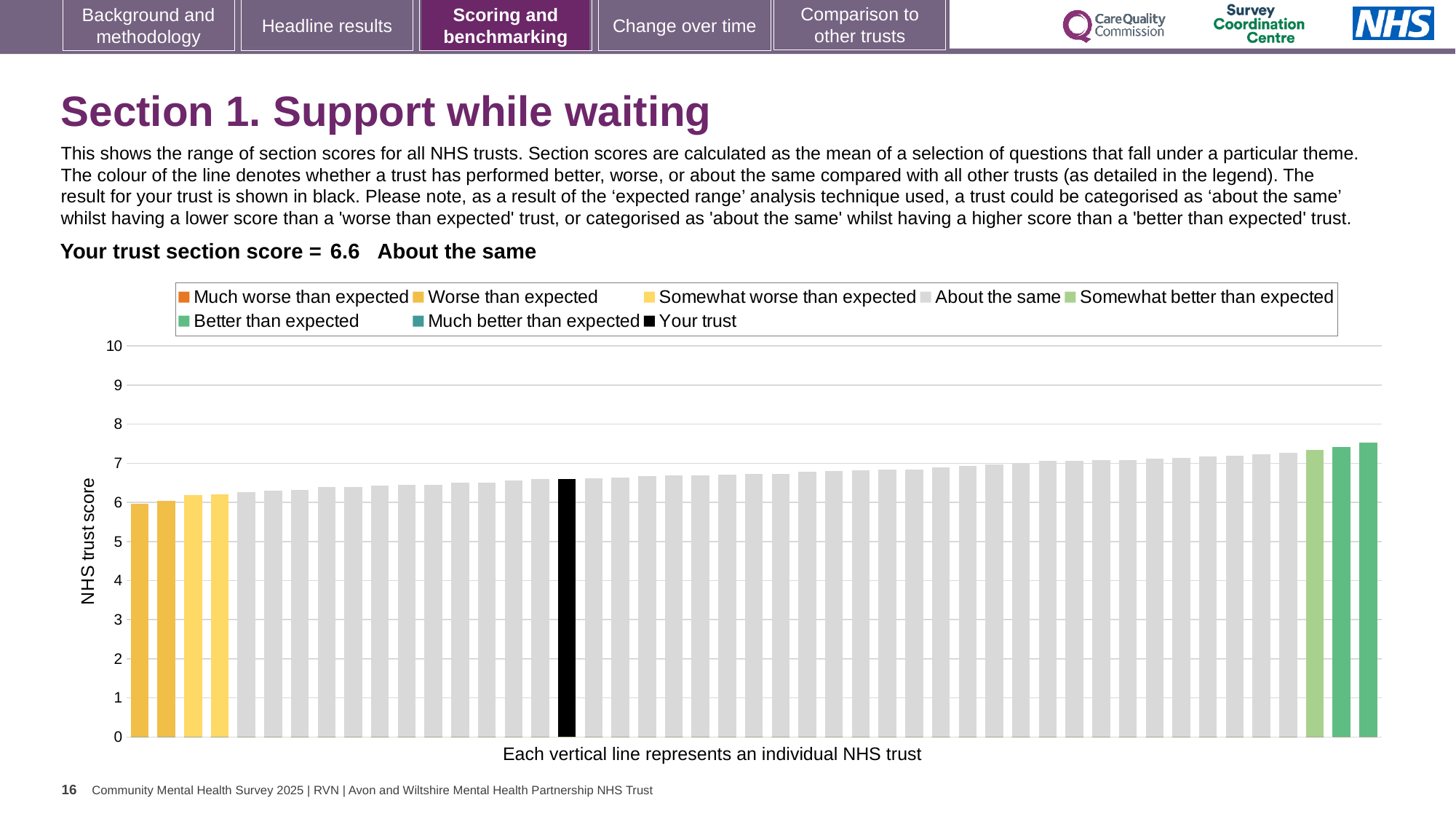
Is the value of the leftmost bar greater or less than 5? greater Which category is your trust placed in for this section? About the same Which legend category does the tallest bar belong to? Better than expected Which is larger, the leftmost bar or the rightmost bar? the rightmost bar Do the bar values rise or fall from left to right along the x axis? rise What is the section score for your trust shown on the slide? 6.6 Is the value for your trust (the black bar) greater or less than 7? less Is the value of the rightmost bar greater or less than 7? greater What is the title of the vertical axis? NHS trust score How many entries does the chart legend list? 8 How many bars are coloured as 'Somewhat better than expected'? 1 What kind of chart is shown on the slide? bar chart